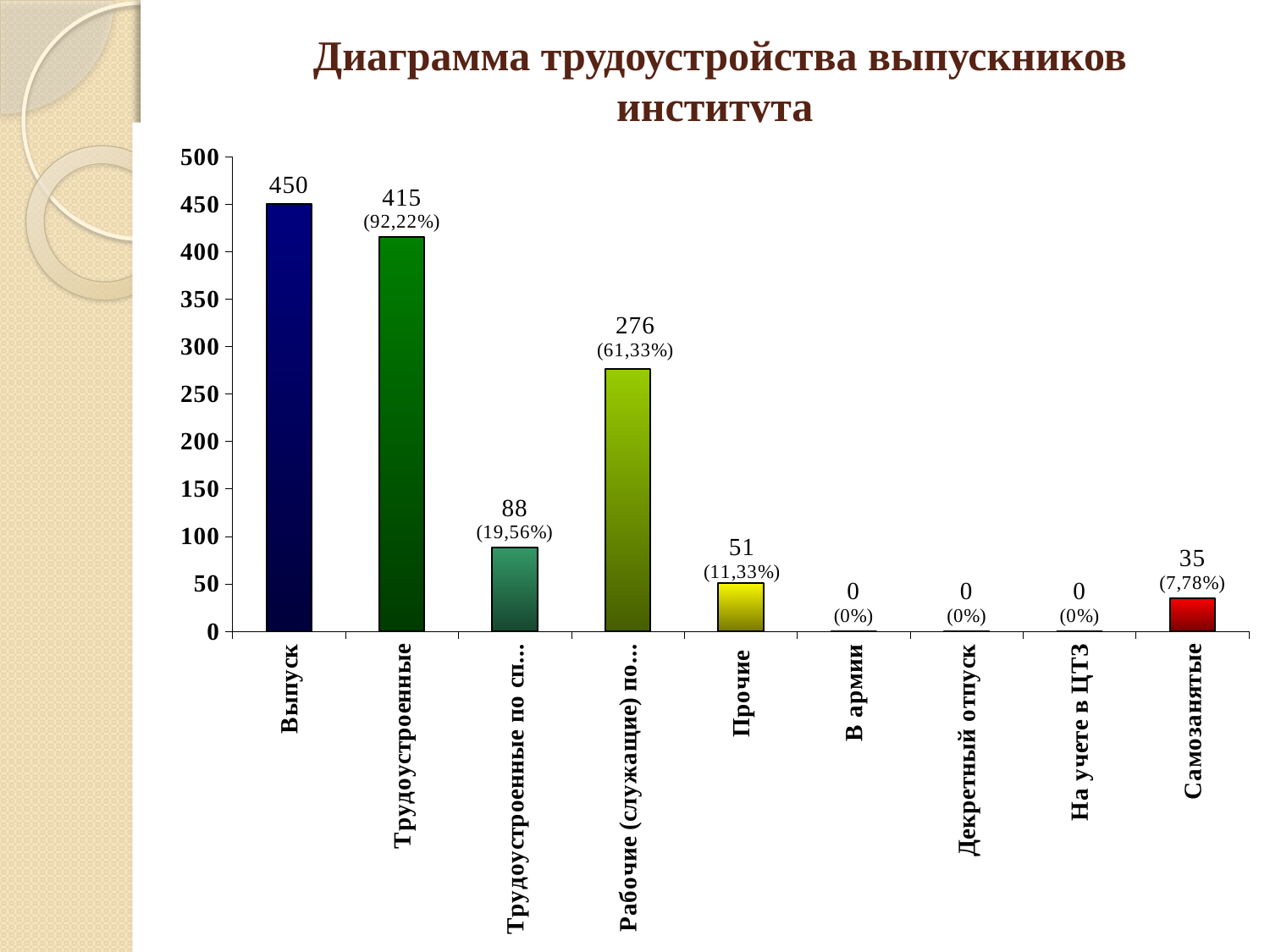
What is the value for Выпуск? 450 What percentage is shown for Самозанятые? 7,78% How many categories are shown on the x axis? 9 Which category has the highest value? Выпуск What type of chart is shown on the slide? bar chart What is the value for Прочие? 51 What is the value for Самозанятые? 35 Which is larger, the value for Прочие or the value for Самозанятые? Прочие Is the value for Прочие greater or less than 100? less What is the value for Трудоустроенные? 415 What is the difference between the values for Выпуск and Трудоустроенные? 35 What is the title of the chart? Диаграмма трудоустройства выпускников института